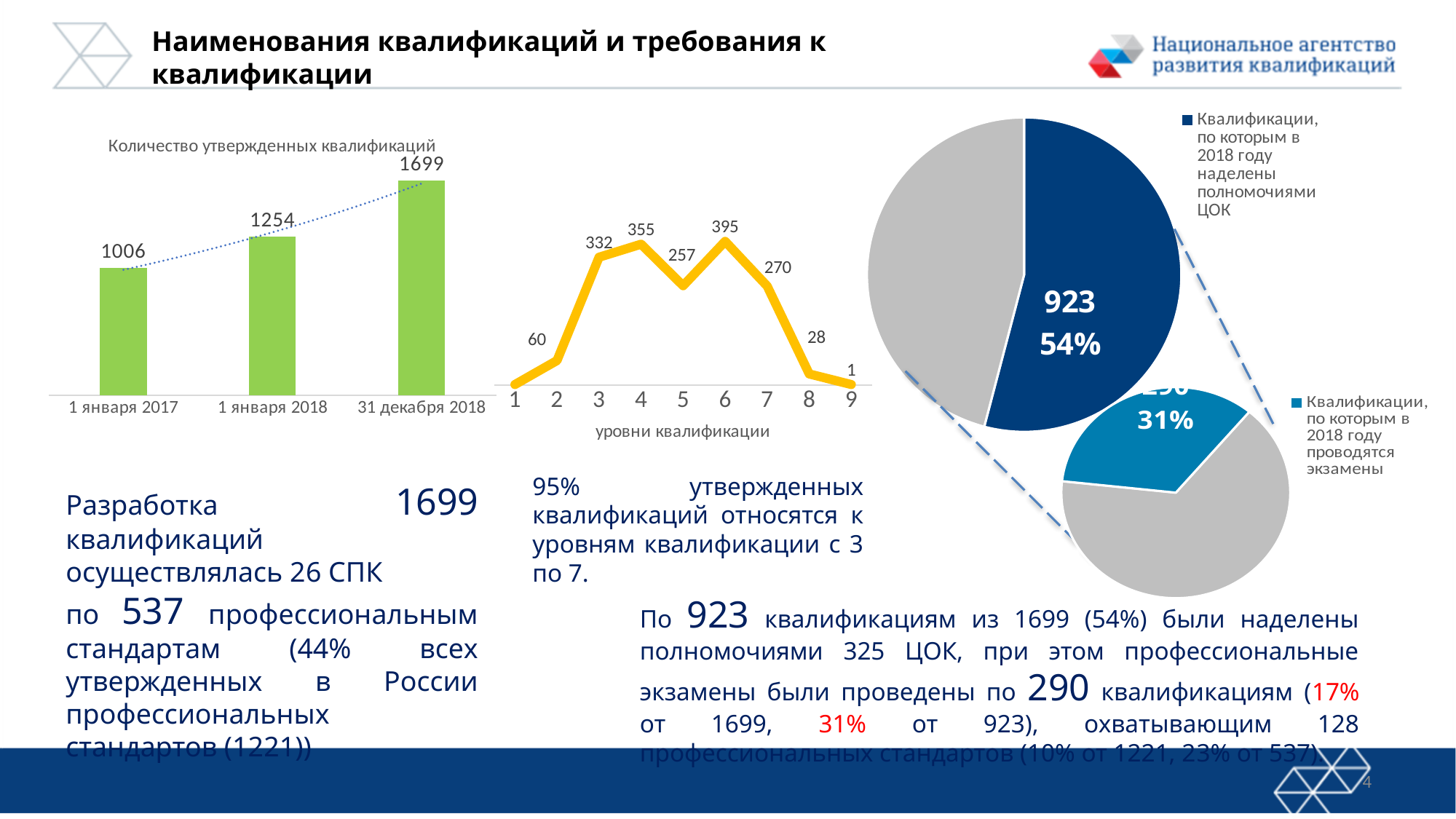
In the line chart 'уровни квалификации', which is larger: the value for level 3 or the value for level 5? level 3 In the line chart 'уровни квалификации', what is the value for level 9? 1 In the bar chart 'Количество утвержденных квалификаций', what is the value for 1 января 2017? 1006 How many bars are in the bar chart 'Количество утвержденных квалификаций'? 3 In the bar chart 'Количество утвержденных квалификаций', what is the value for 31 декабря 2018? 1699 In the line chart 'уровни квалификации', what is the difference between the values for level 4 and level 7? 85 In the large pie chart on the right, what share is shown for the dark blue slice 'Квалификации, по которым в 2018 году наделены полномочиями ЦОК'? 54% In the bar chart 'Количество утвержденных квалификаций', do the values rise or fall from left to right? rise In the line chart 'уровни квалификации', what is the value for level 6? 395 In the bar chart 'Количество утвержденных квалификаций', what is the difference between the values for 1 января 2018 and 1 января 2017? 248 In the line chart 'уровни квалификации', which level has the highest value? 6 What kind of chart is the chart in the middle of the slide with levels 1 to 9 on the x axis? line chart